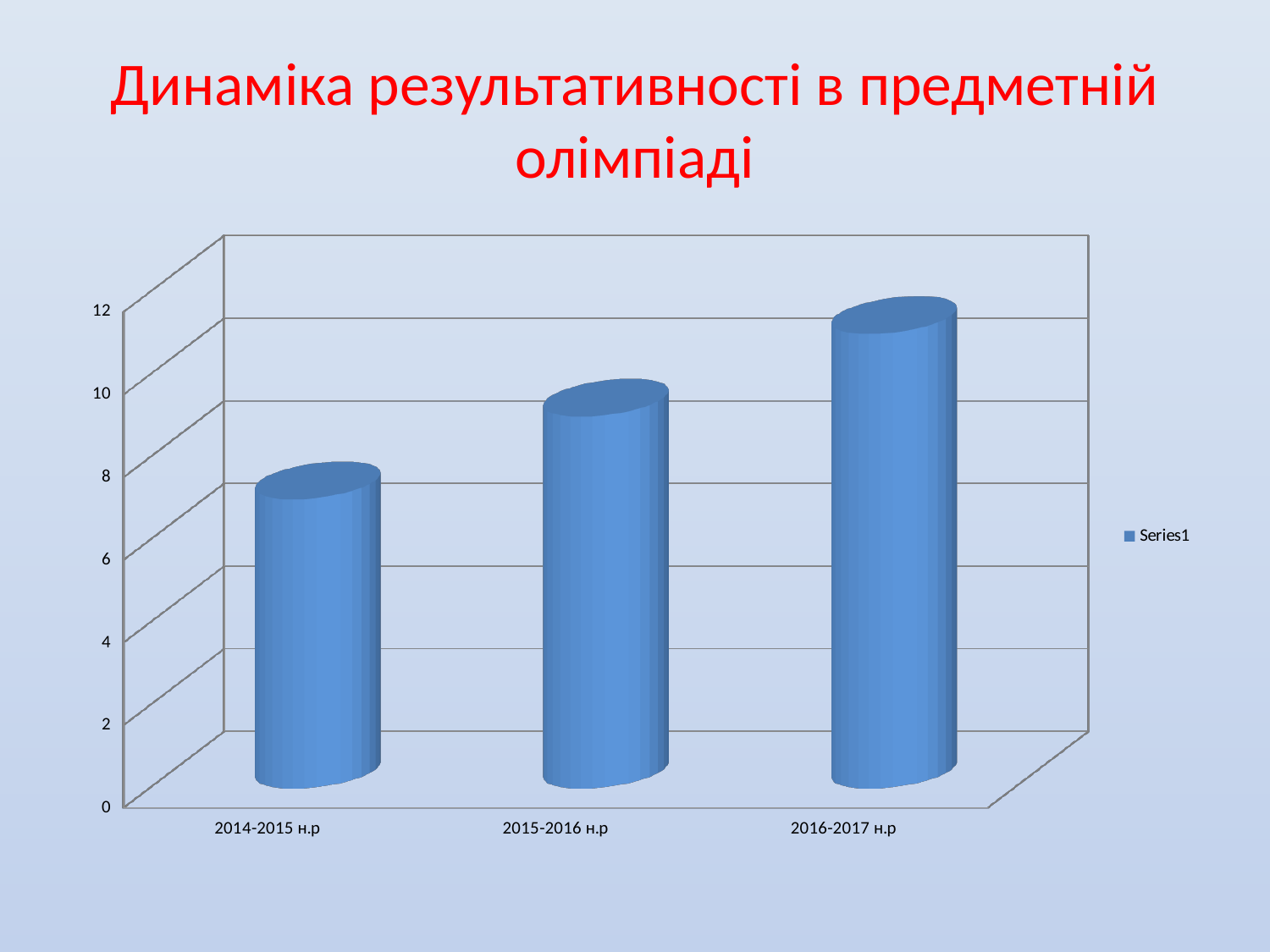
What kind of chart is shown on the slide? bar chart Is the value for 2016-2017 н.р greater or less than 8? greater Do the values rise or fall from 2014-2015 н.р to 2016-2017 н.р? rise Which category has the highest bar? 2016-2017 н.р How many categories are shown on the x axis of the chart? 3 What is the title of the slide containing the chart? Динаміка результативності в предметній олімпіаді What is the name of the series shown in the chart legend? Series1 Which category has the lowest bar? 2014-2015 н.р How many series does the chart legend list? 1 Is the value for 2014-2015 н.р greater or less than 10? less Which is larger, the value for 2015-2016 н.р or the value for 2014-2015 н.р? 2015-2016 н.р Is the value for 2015-2016 н.р greater or less than 6? greater